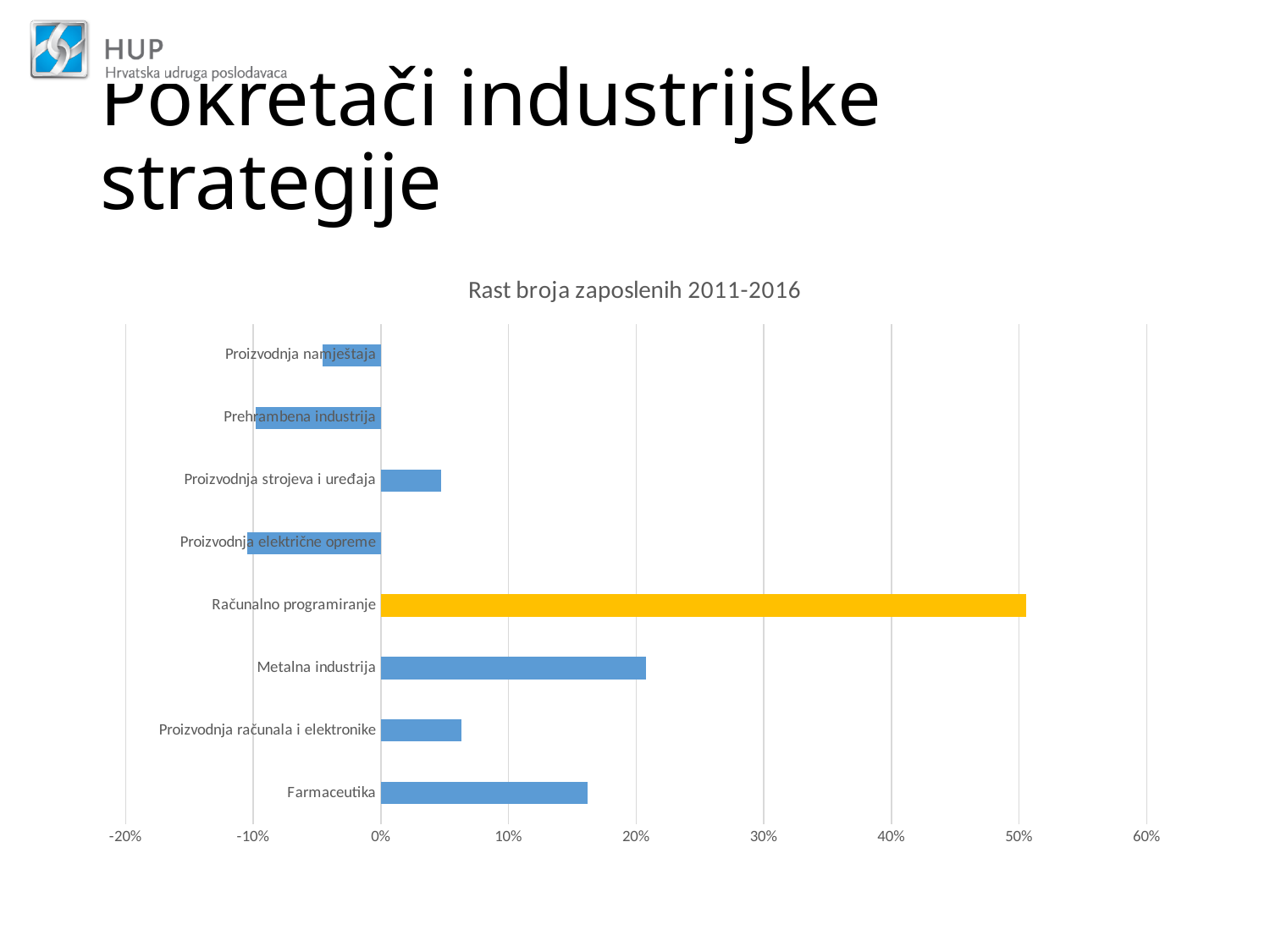
Is the value for Računalno programiranje greater or less than 40%? greater Is the value for Prehrambena industrija greater or less than 0%? less What is the title of the chart? Rast broja zaposlenih 2011-2016 What colour is the bar for Računalno programiranje? yellow Which category has the highest value? Računalno programiranje Is the value for Farmaceutika greater or less than 20%? less How many categories are shown in the chart? 8 What type of chart is shown on the slide? bar chart Which is larger, the value for Metalna industrija or the value for Farmaceutika? Metalna industrija Which is larger, the value for Farmaceutika or the value for Proizvodnja strojeva i uređaja? Farmaceutika